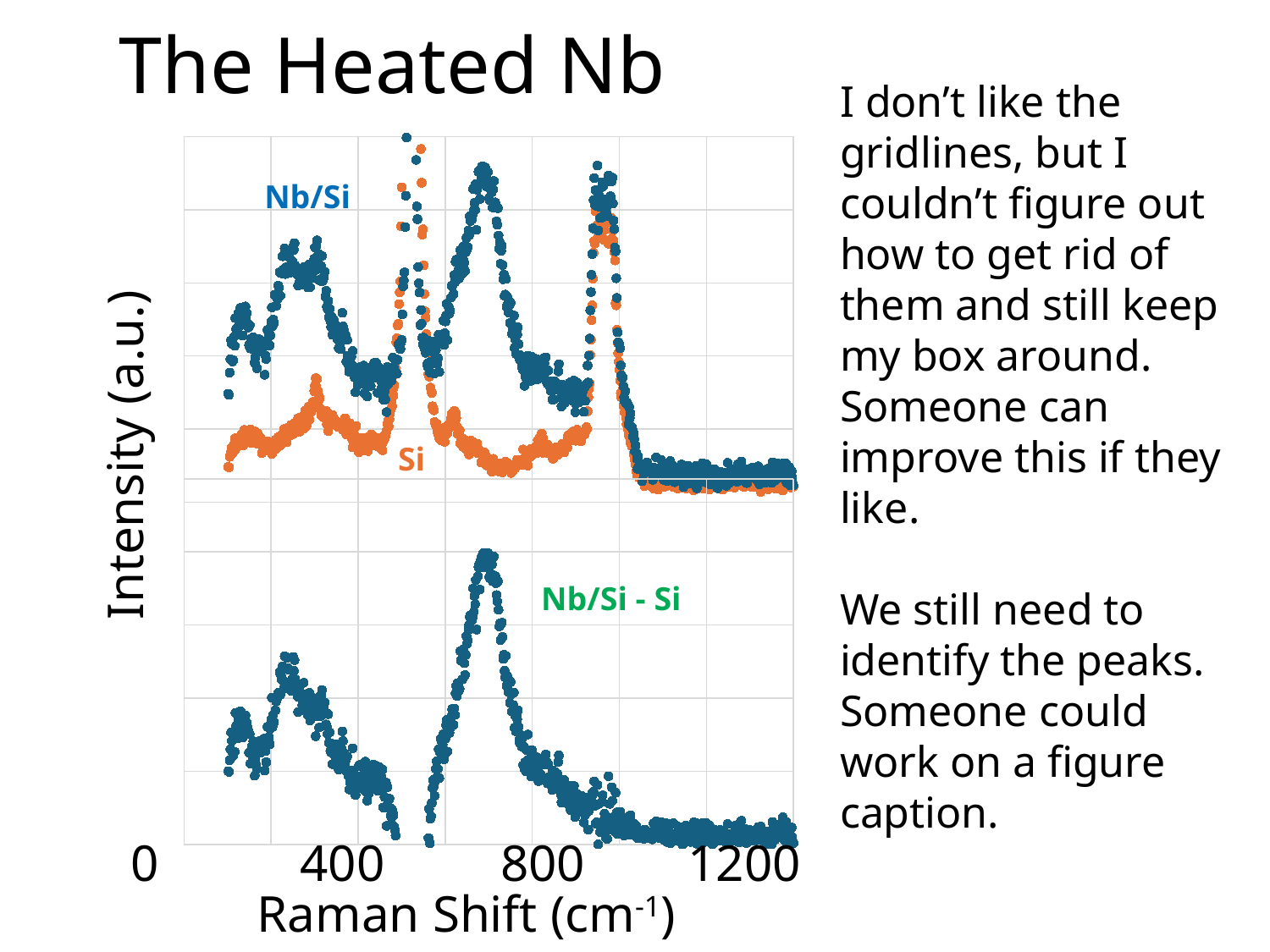
Which series, Nb/Si or Si, is plotted higher on the chart at a Raman shift of 400? Nb/Si Which series on the chart is labelled in orange? Si Does the Nb/Si - Si trace rise or fall between a Raman shift of 800 and 1200? fall What is the label of the series plotted in the lower part of the chart? Nb/Si - Si Is the Raman shift of the tallest peak of the Nb/Si - Si trace greater or less than 800? less What is the label of the y axis of the chart? Intensity (a.u.) How many labelled data series are plotted on the chart? 3 Is the Raman shift of the sharp narrow peak of the Si trace greater or less than 400? greater What is the largest tick value shown on the x axis of the chart? 1200 What kind of chart is shown on the slide? scatter chart What is the label of the x axis of the chart? Raman Shift (cm-1) Is the Raman shift at which the Nb/Si trace drops to its flat baseline greater or less than 800? greater